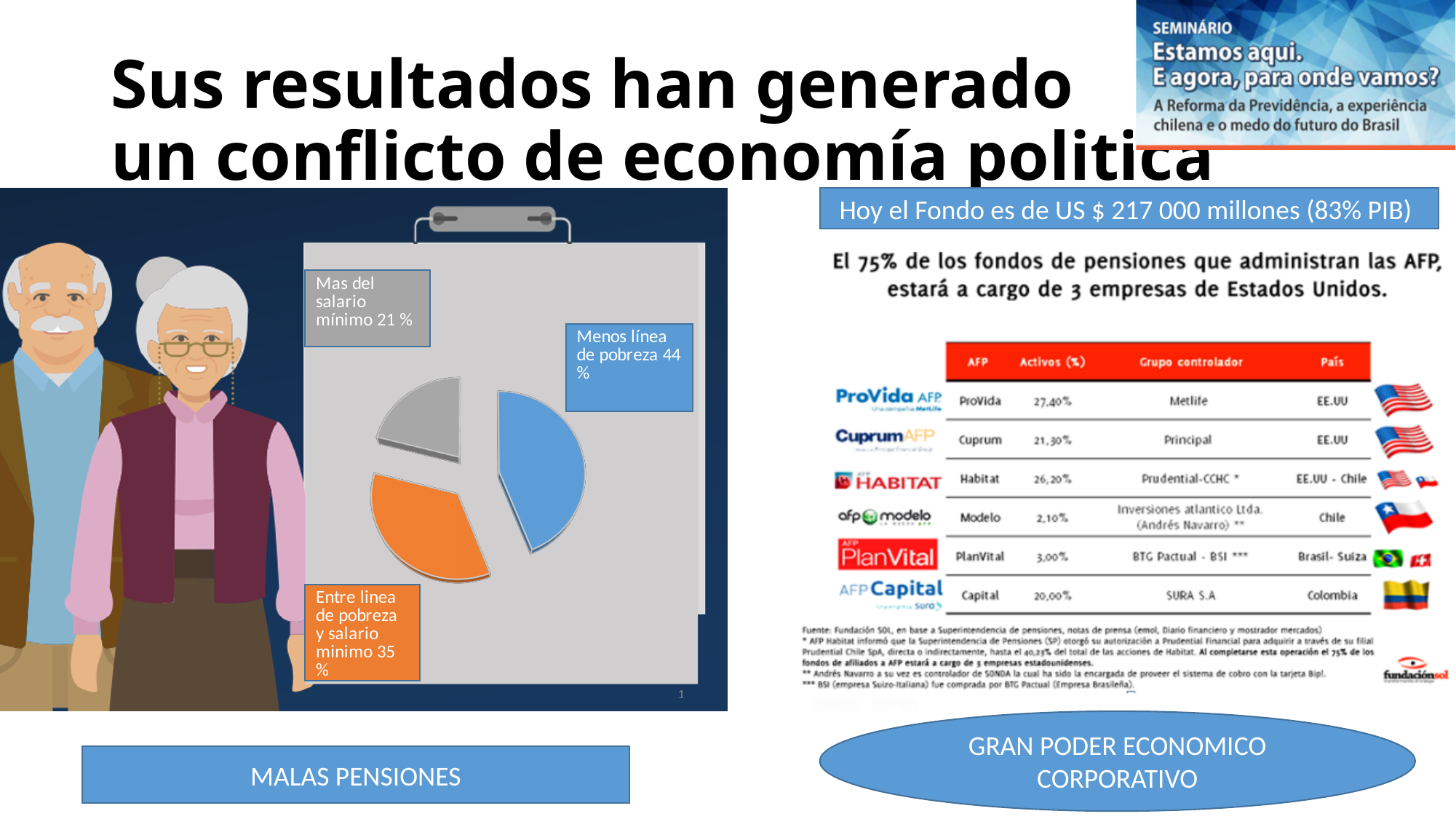
What is the difference between the 'Entre linea de pobreza y salario minimo' and 'Mas del salario mínimo' values in the pie chart? 14 % What is the value for 'Menos línea de pobreza' in the pie chart? 44 % What share of the pie does the 'Menos línea de pobreza' slice represent? 44 % How many slices does the pie chart have? 3 What kind of chart is shown on the left side of the slide? pie chart In the pie chart, which is larger: 'Entre linea de pobreza y salario minimo' or 'Mas del salario mínimo'? Entre linea de pobreza y salario minimo Which category has the smallest slice in the pie chart? Mas del salario mínimo What is the value for 'Mas del salario mínimo' in the pie chart? 21 % What is the difference between the 'Menos línea de pobreza' and 'Mas del salario mínimo' values in the pie chart? 23 % What is the value for 'Entre linea de pobreza y salario minimo' in the pie chart? 35 % What colour is the 'Entre linea de pobreza y salario minimo' slice in the pie chart? orange Which category has the largest slice in the pie chart? Menos línea de pobreza